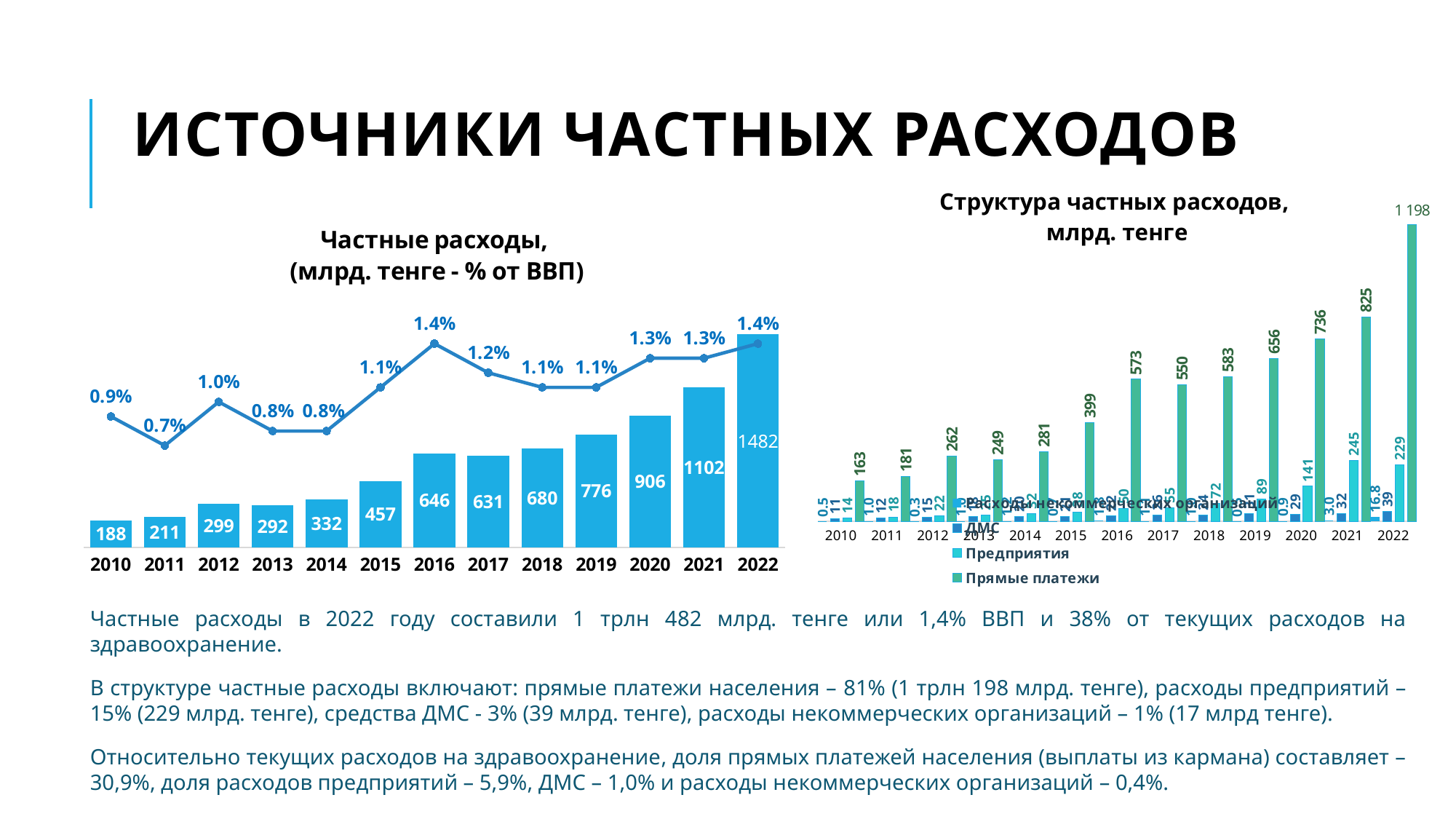
In the chart 'Частные расходы, (млрд. тенге - % от ВВП)', which year has the lowest percentage of GDP on the line? 2011 In the chart 'Частные расходы, (млрд. тенге - % от ВВП)', do the bar values rise or fall from 2018 to 2022? rise In the chart 'Структура частных расходов, млрд. тенге', what is the value of 'Прямые платежи' for 2022? 1 198 In the chart 'Частные расходы, (млрд. тенге - % от ВВП)', which year has the larger bar value, 2016 or 2017? 2016 In the chart 'Частные расходы, (млрд. тенге - % от ВВП)', how many years are shown on the x axis? 13 In the chart 'Структура частных расходов, млрд. тенге', what is the value of 'Прямые платежи' for 2016? 573 How many series does the legend of the chart 'Структура частных расходов, млрд. тенге' list? 4 In the chart 'Частные расходы, (млрд. тенге - % от ВВП)', what is the difference between the bar values for 2022 and 2021? 380 In the chart 'Частные расходы, (млрд. тенге - % от ВВП)', what percentage of GDP is shown for 2016? 1.4% What kind of chart is 'Структура частных расходов, млрд. тенге'? bar chart In the chart 'Частные расходы, (млрд. тенге - % от ВВП)', which year has the highest bar? 2022 In the chart 'Частные расходы, (млрд. тенге - % от ВВП)', what is the bar value for 2022? 1482